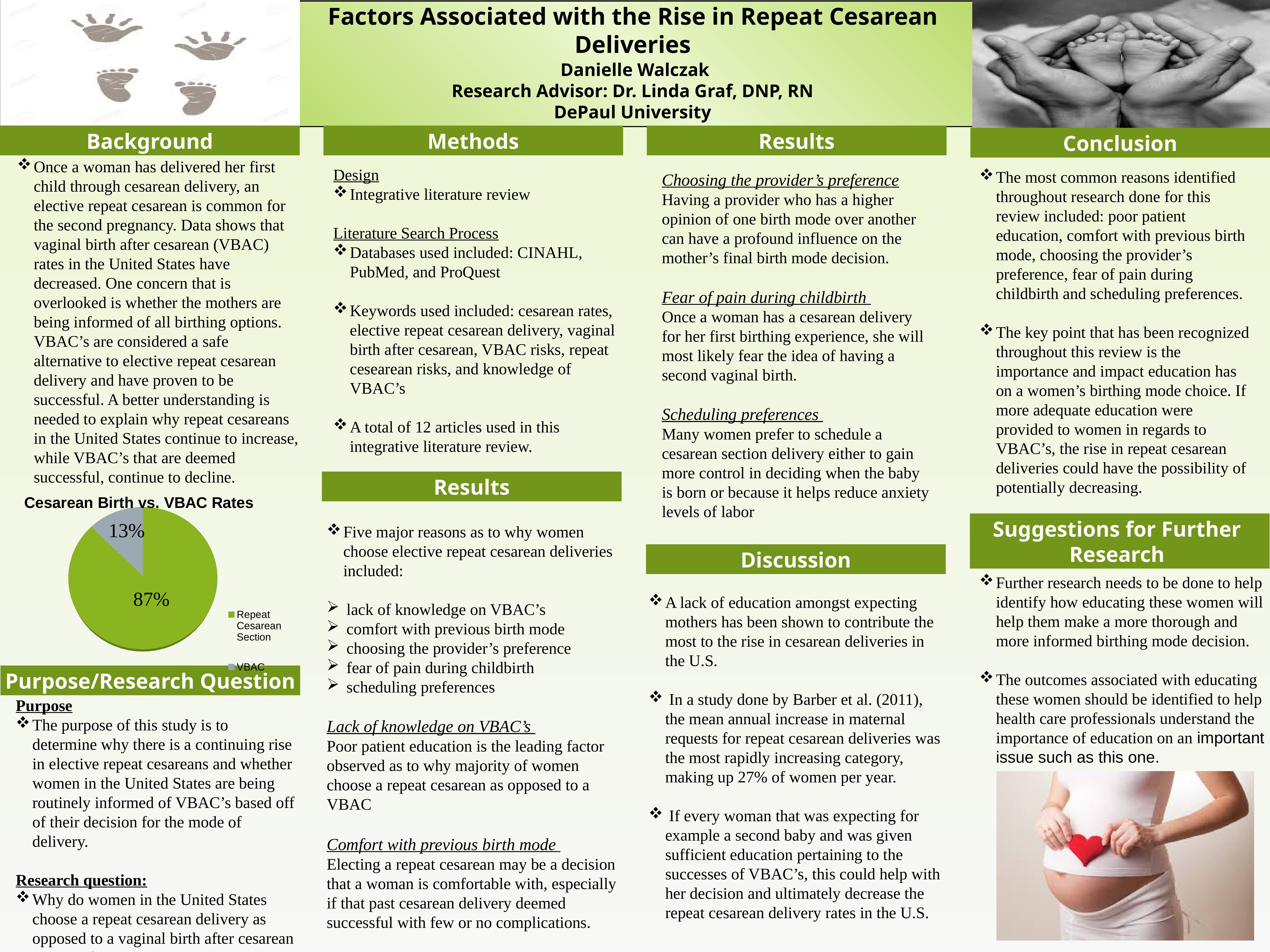
Which is larger in the pie chart, Repeat Cesarean Section or VBAC? Repeat Cesarean Section What is the total of the two slices shown in the pie chart? 100% What is the difference in percentage points between the Repeat Cesarean Section slice and the VBAC slice? 74 Which category has the largest slice in the pie chart? Repeat Cesarean Section What is the title of the pie chart? Cesarean Birth vs. VBAC Rates What colour is the Repeat Cesarean Section slice in the pie chart? green What type of chart is shown under the Background section? pie chart How many entries does the pie chart legend list? 2 What share of the pie chart is Repeat Cesarean Section? 87% What share of the pie chart is VBAC? 13% How many categories does the pie chart show? 2 Which category has the smallest slice in the pie chart? VBAC